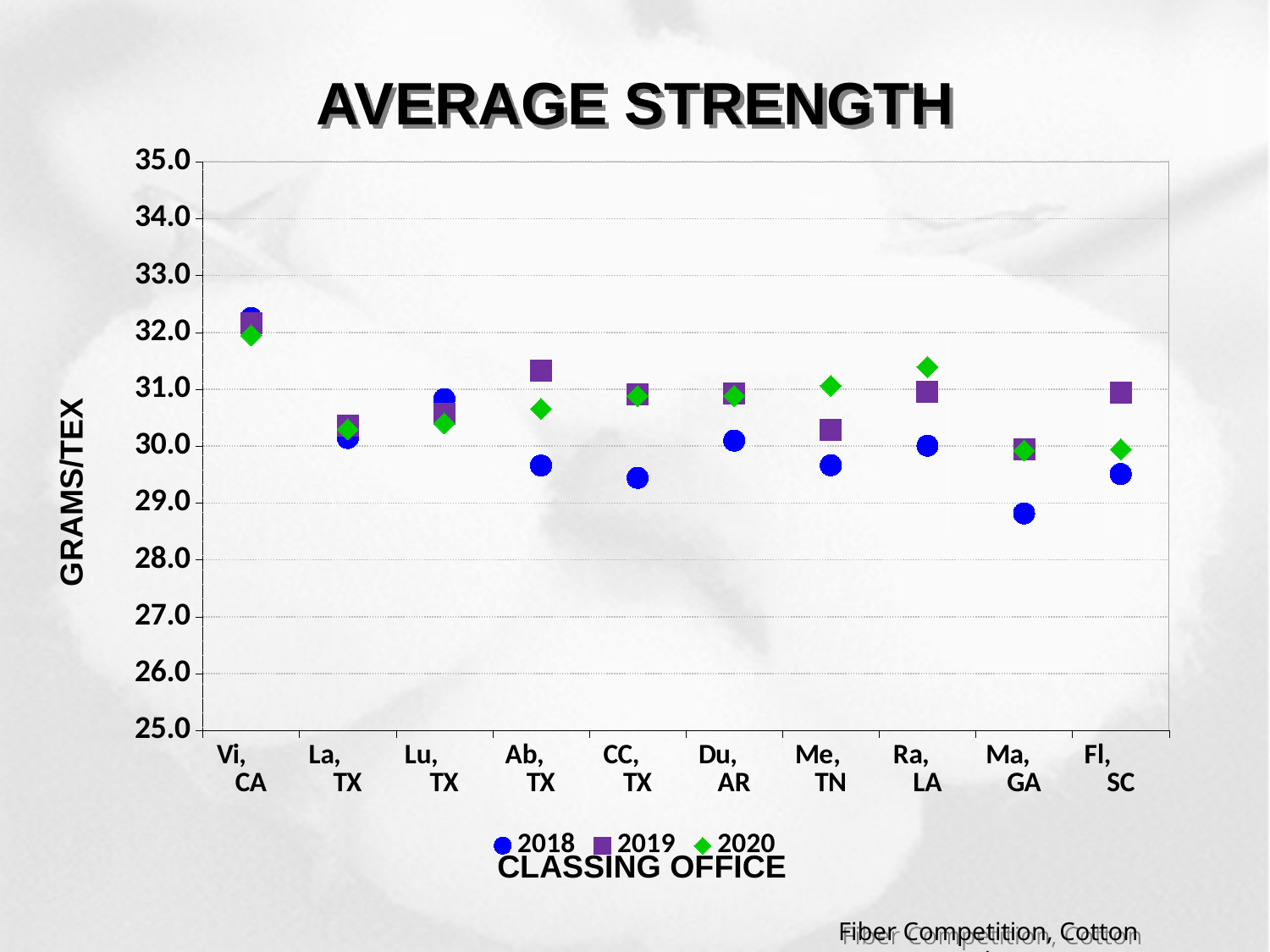
Is the 2018 value for CC, TX greater or less than 30.0? less Which classing office has the highest 2018 average strength? Vi, CA For Me, TN, which series has the larger value, 2018 or 2020? 2020 What is the label on the y axis of the chart? GRAMS/TEX Which classing office has the lowest 2018 average strength? Ma, GA Is the 2018 value for Ma, GA greater or less than 29.0? less What kind of chart is shown on the slide? scatter chart Which classing office has the highest 2020 average strength? Vi, CA Is the 2019 value for Ab, TX greater or less than 31.0? greater How many series does the legend list? 3 How many classing offices are shown on the x axis? 10 For Ab, TX, which series has the larger value, 2018 or 2019? 2019